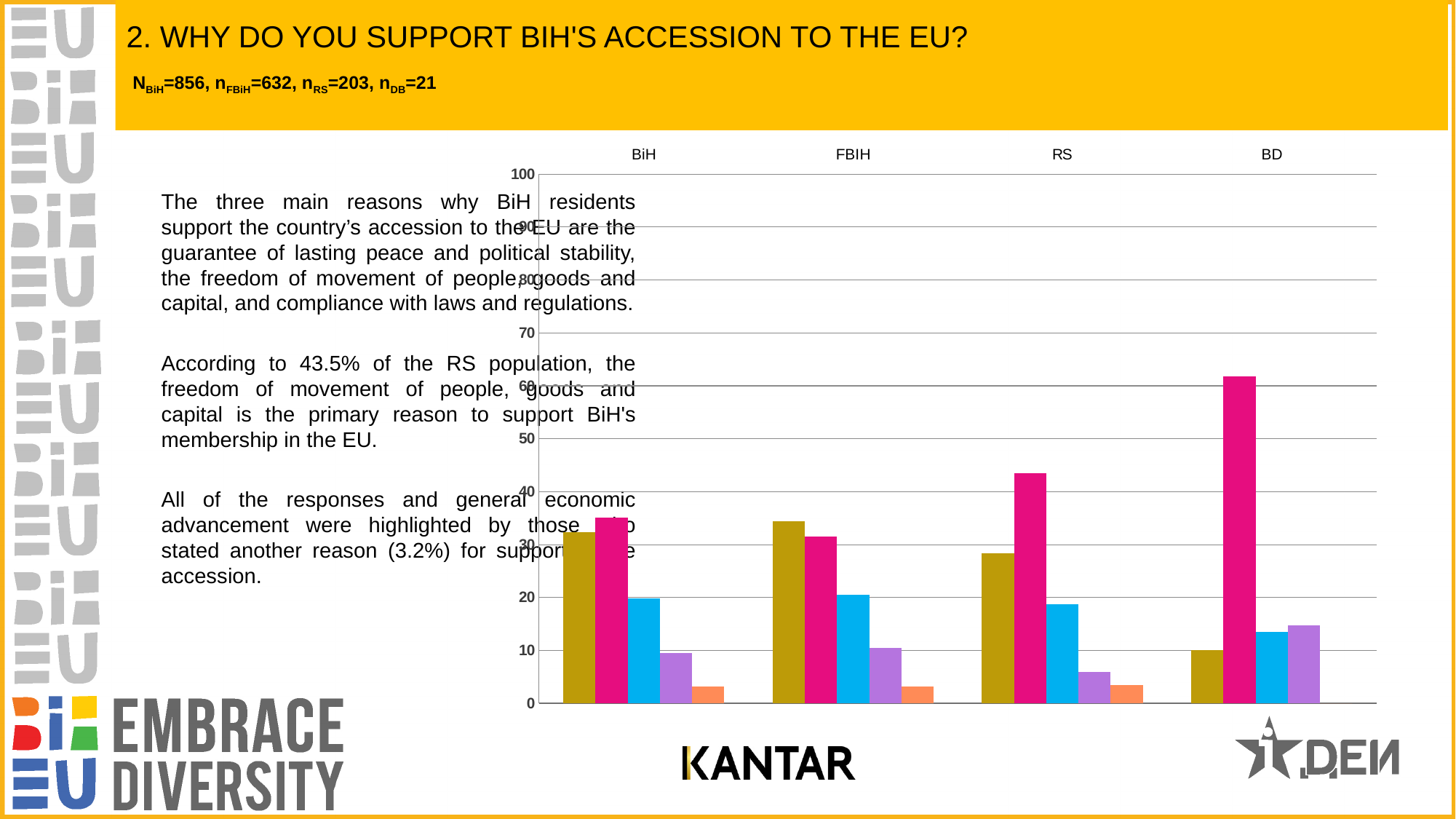
How many categories are shown along the x axis of the chart? 4 What is the highest value shown on the chart's y axis? 100 Which category has the lowest olive (first) bar? BD Which category contains the tallest bar in the chart? BD In the RS group, which is taller: the olive bar or the magenta bar? magenta Is the olive (first) bar for BD greater or less than 20? less Is the magenta bar for BD greater or less than 50? greater What kind of chart is shown on the slide? bar chart Which categories are labelled along the top of the chart? BiH, FBIH, RS, BD In the BD group, which is taller: the magenta bar or the light blue bar? magenta Is the magenta bar for RS greater or less than 40? greater Which category has the highest magenta bar? BD